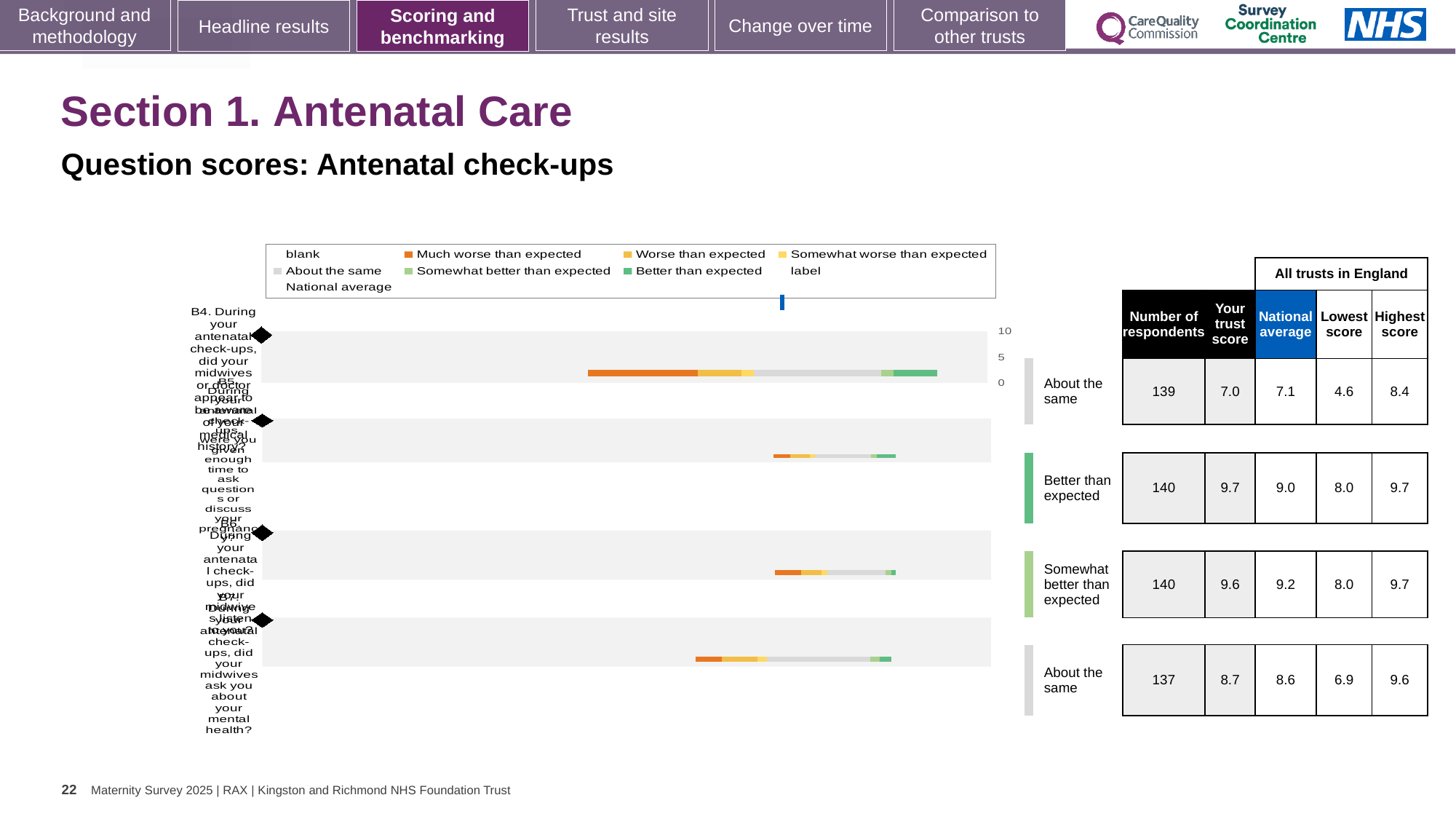
How many entries does the chart legend list? 9 In the table beside the chart, what is the 'Your trust score' value in the second row (labelled 'Better than expected')? 9.7 In the table beside the chart, what is the national average in the third row (labelled 'Somewhat better than expected')? 9.2 What is the highest tick value shown on the chart's axis? 10 How many bars are plotted in the chart? 4 In the table beside the chart, in the second row, is the trust score or the national average larger? trust score In the table beside the chart, what is the number of respondents in the first row (labelled 'About the same')? 139 In the table beside the chart, what is the difference between the trust score and the national average in the second row? 0.7 In the table beside the chart, which row has the highest 'Your trust score'? Better than expected (second row) In the table beside the chart, what is the lowest score in the fourth row (labelled 'About the same')? 6.9 What kind of chart is shown on the slide? bar chart In the table beside the chart, which row has the lowest number of respondents? the fourth row (About the same), 137